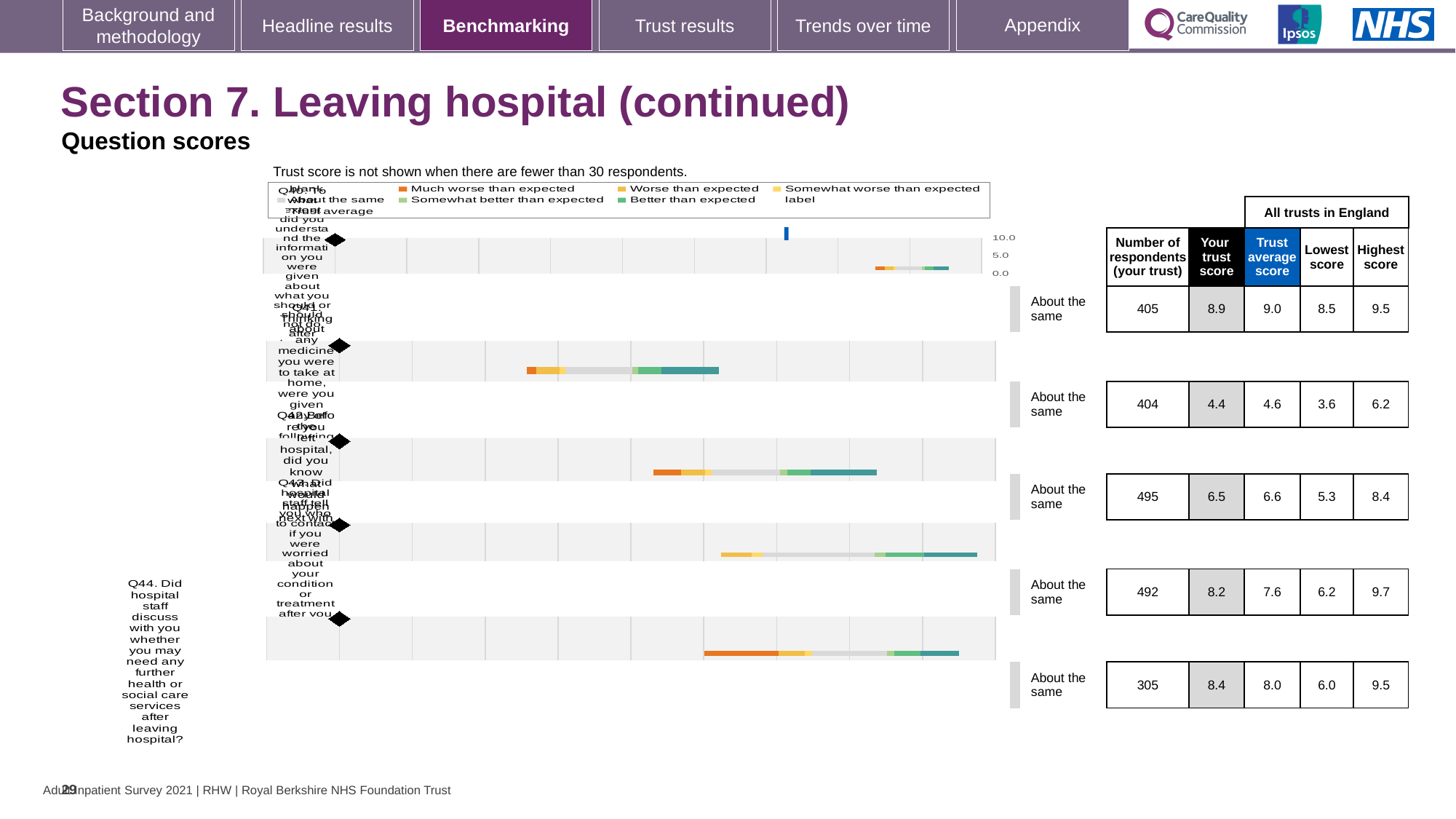
What is the difference between the trust score (8.2) and the all-trusts average (7.6) for Q43? 0.6 Which question has the highest 'Your trust score' on this slide? Q40 How many respondents answered Q44 at this trust? 305 What is the lowest score among all trusts in England for Q42 (knowing what would happen next with your care)? 5.3 What is the trust average score across all trusts in England for Q41 (medicines to take at home)? 4.6 What type of chart is used to show the question scores? Bar chart How many questions are plotted on this slide? 5 Which question has the lowest 'Your trust score' on this slide? Q41 What is the trust score for Q44 (whether hospital staff discussed further health or social care services after leaving hospital)? 8.4 For Q44, is the trust score (8.4) higher or lower than the all-trusts average (8.0)? higher What benchmark category is shown for each question on this slide? About the same What is the highest score among all trusts in England for Q43 (who to contact if worried after leaving hospital)? 9.7